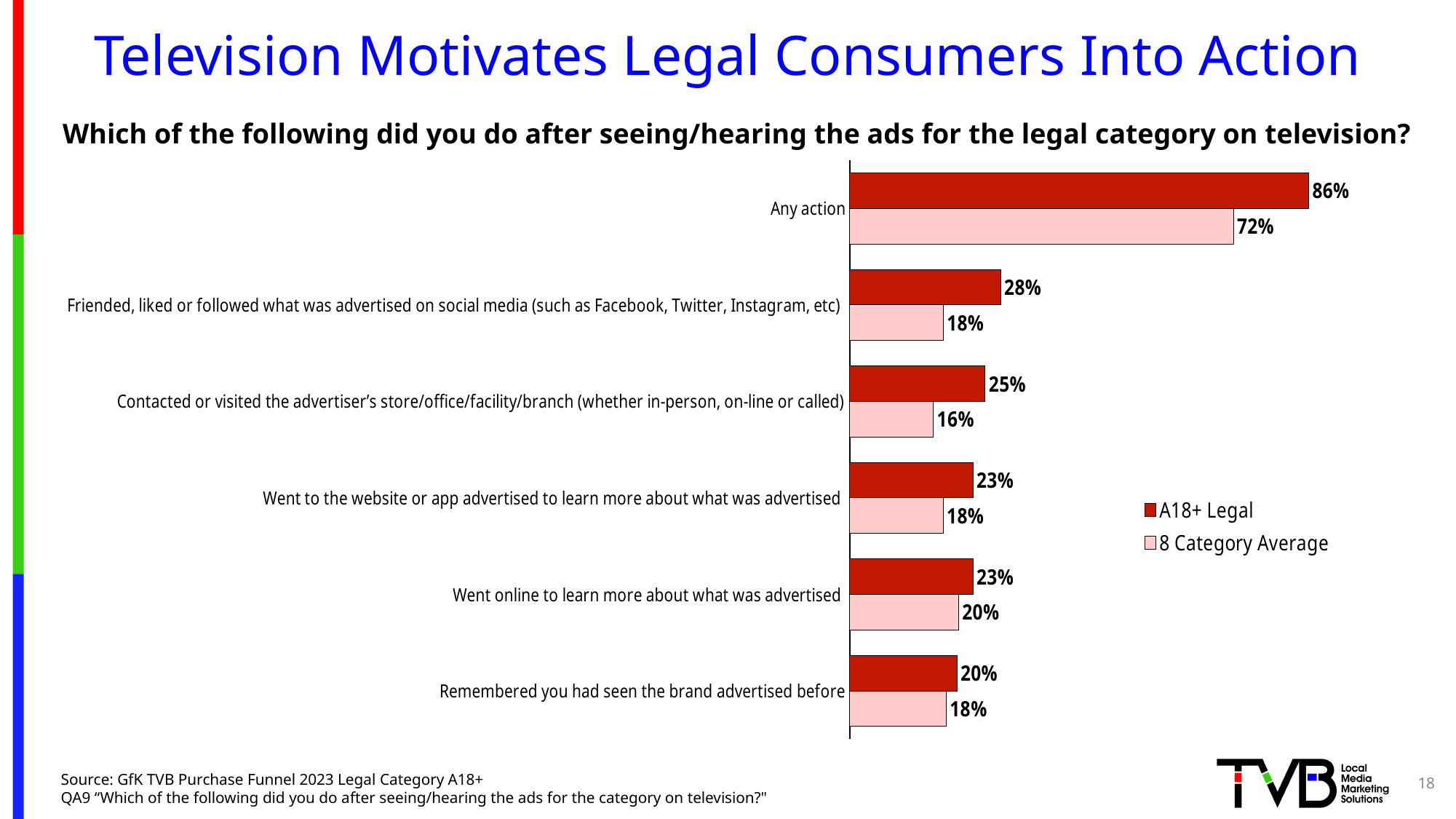
How many categories are shown in the chart? 6 For "Went online to learn more about what was advertised", which is larger: A18+ Legal or 8 Category Average? A18+ Legal What is the 8 Category Average value for "Contacted or visited the advertiser's store/office/facility/branch"? 16% Which category has the lowest 8 Category Average value? Contacted or visited the advertiser's store/office/facility/branch (whether in-person, on-line or called) Which category has the highest A18+ Legal value? Any action What is the A18+ Legal value for "Remembered you had seen the brand advertised before"? 20% What is the A18+ Legal value for "Any action"? 86% What type of chart is shown on the slide? Bar chart What is the A18+ Legal value for "Friended, liked or followed what was advertised on social media"? 28% What is the difference between the A18+ Legal and 8 Category Average values for "Any action"? 14 percentage points How many series does the legend list? 2 What is the 8 Category Average value for "Any action"? 72%